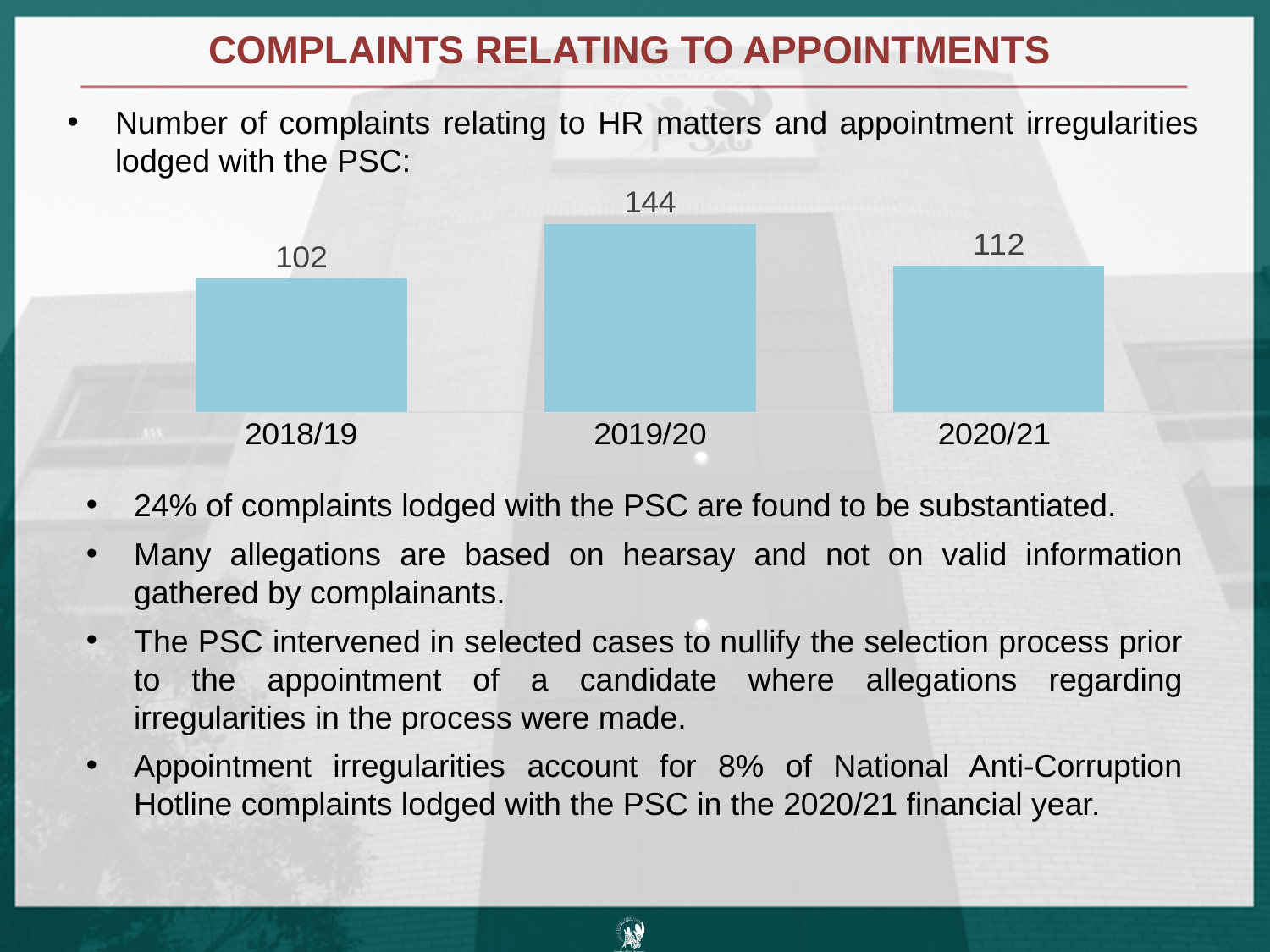
Which financial year has the lowest number of complaints? 2018/19 What is the difference between the number of complaints in 2019/20 and 2020/21? 32 What is the number of complaints for 2019/20? 144 What is the difference between the number of complaints in 2019/20 and 2018/19? 42 What kind of chart is shown on the slide? Bar chart Which financial year has the highest number of complaints? 2019/20 How many financial years are shown in the chart? 3 Which year has more complaints, 2018/19 or 2020/21? 2020/21 Did the number of complaints rise or fall from 2019/20 to 2020/21? Fall What is the number of complaints for 2020/21? 112 What is the number of complaints for 2018/19? 102 What colour are the bars in the chart? Light blue